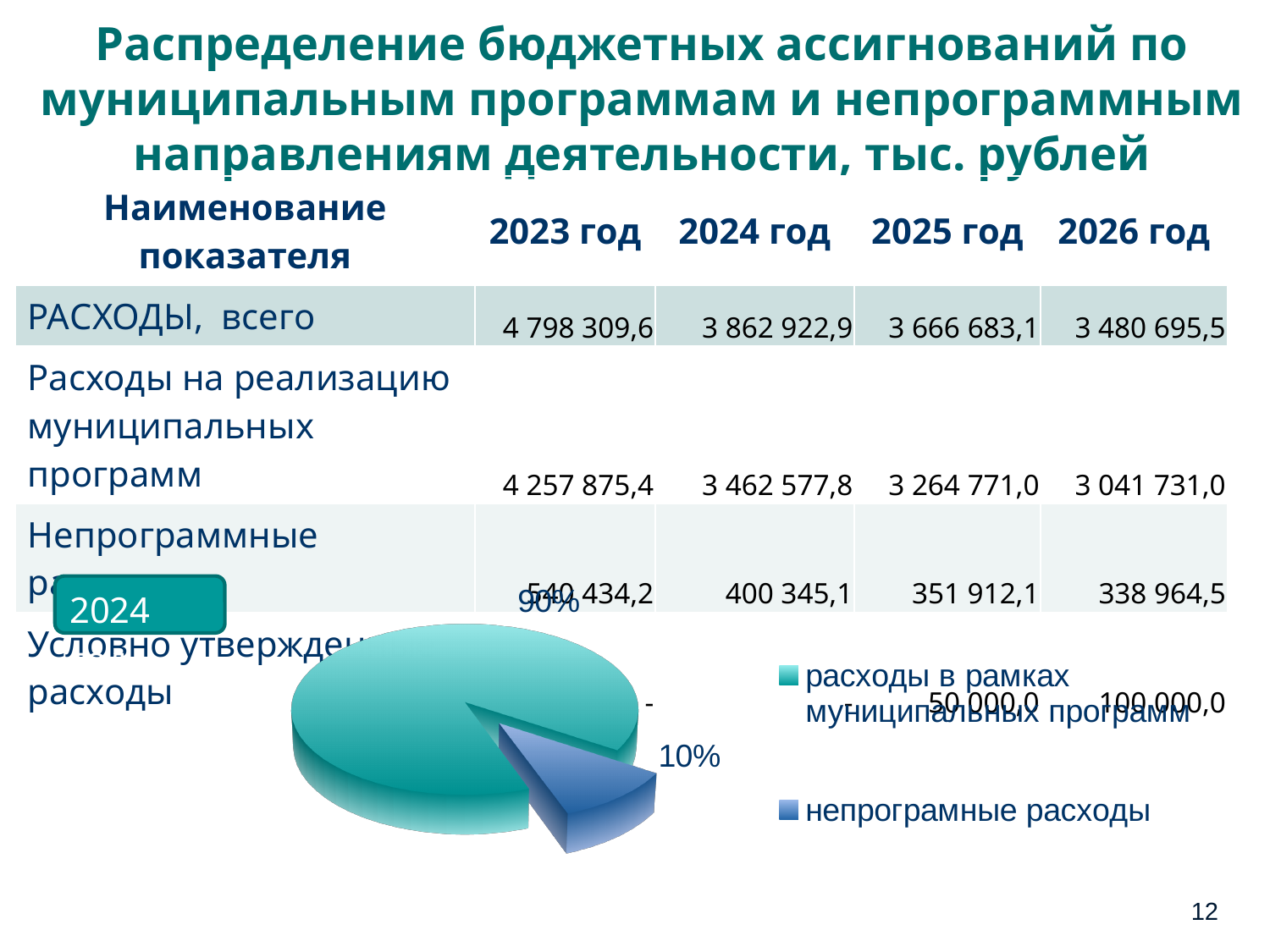
In the pie chart, which is larger: 'расходы в рамках муниципальных программ' or 'непрограмные расходы'? расходы в рамках муниципальных программ What is the difference in percentage points between the two slices of the pie chart? 80 What kind of chart is shown at the bottom of the slide? pie chart What share of the pie does 'непрограмные расходы' take? 10% Which year is the pie chart labelled with? 2024 How many entries does the pie chart's legend list? 2 Which slice of the pie chart is the smallest? непрограмные расходы Which slice of the pie chart is the largest? расходы в рамках муниципальных программ What colour is the 'непрограмные расходы' slice in the pie chart? blue What share of the pie does 'расходы в рамках муниципальных программ' take? 90% How many slices does the pie chart have? 2